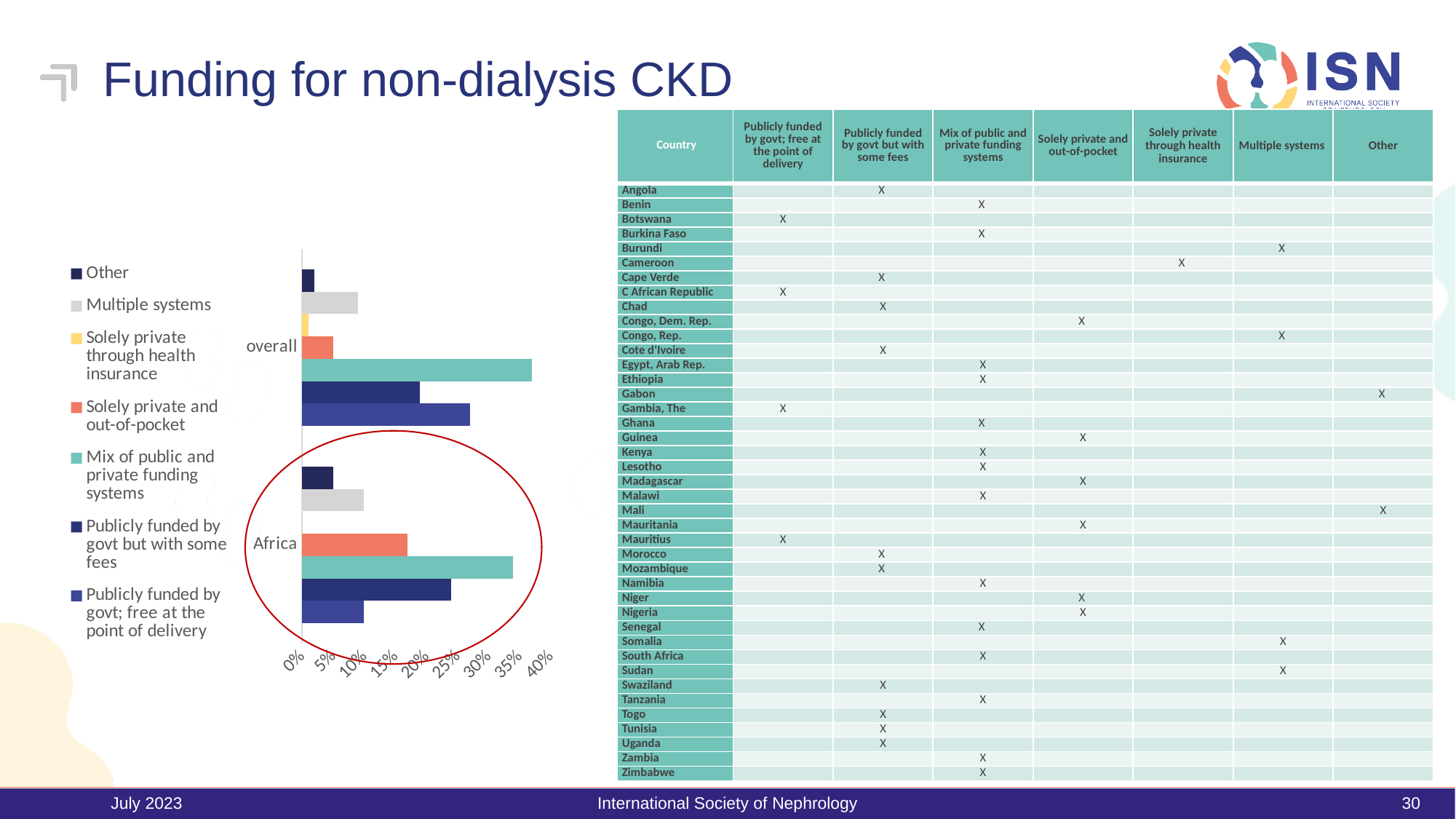
For 'Publicly funded by govt; free at the point of delivery', which category has the larger value: 'overall' or 'Africa'? overall Which category on the chart is circled in red? Africa For the 'Africa' category, which funding series has the shortest bar? Solely private through health insurance Is the 'Africa' value for 'Publicly funded by govt but with some fees' greater or less than 20%? greater For the 'Africa' category, which funding series has the longest bar? Mix of public and private funding systems Is the 'Africa' value for 'Publicly funded by govt; free at the point of delivery' greater or less than 15%? less For the 'overall' category, which funding series has the longest bar? Mix of public and private funding systems For 'Africa', which is larger: 'Solely private and out-of-pocket' or 'Multiple systems'? Solely private and out-of-pocket What kind of chart is shown on the slide? bar chart How many series does the chart legend list? 7 Is the 'overall' value for 'Mix of public and private funding systems' greater or less than 35%? greater How many categories are plotted on the chart's vertical axis? 2